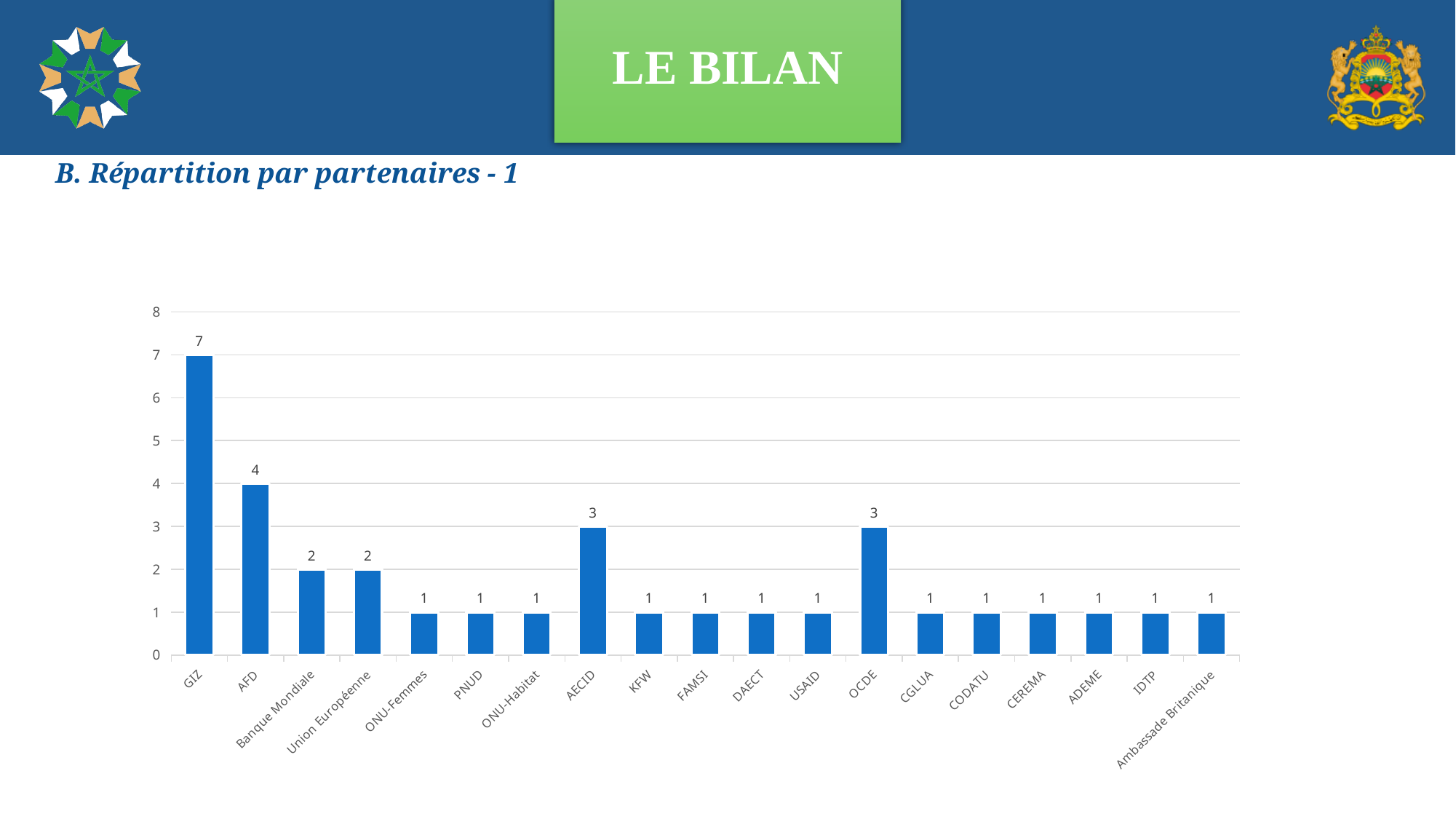
What kind of chart is shown on the slide? bar chart Which partner has the highest value? GIZ What is the value for Banque Mondiale? 2 What is the difference between the values for OCDE and Union Européenne? 1 How many partners are shown on the x axis? 19 What is the value for AECID? 3 What is the value for AFD? 4 What is the heading above the chart? B. Répartition par partenaires - 1 Which is larger, the value for AFD or the value for AECID? AFD What is the difference between the values for GIZ and AFD? 3 What is the value for GIZ? 7 What is the value for USAID? 1